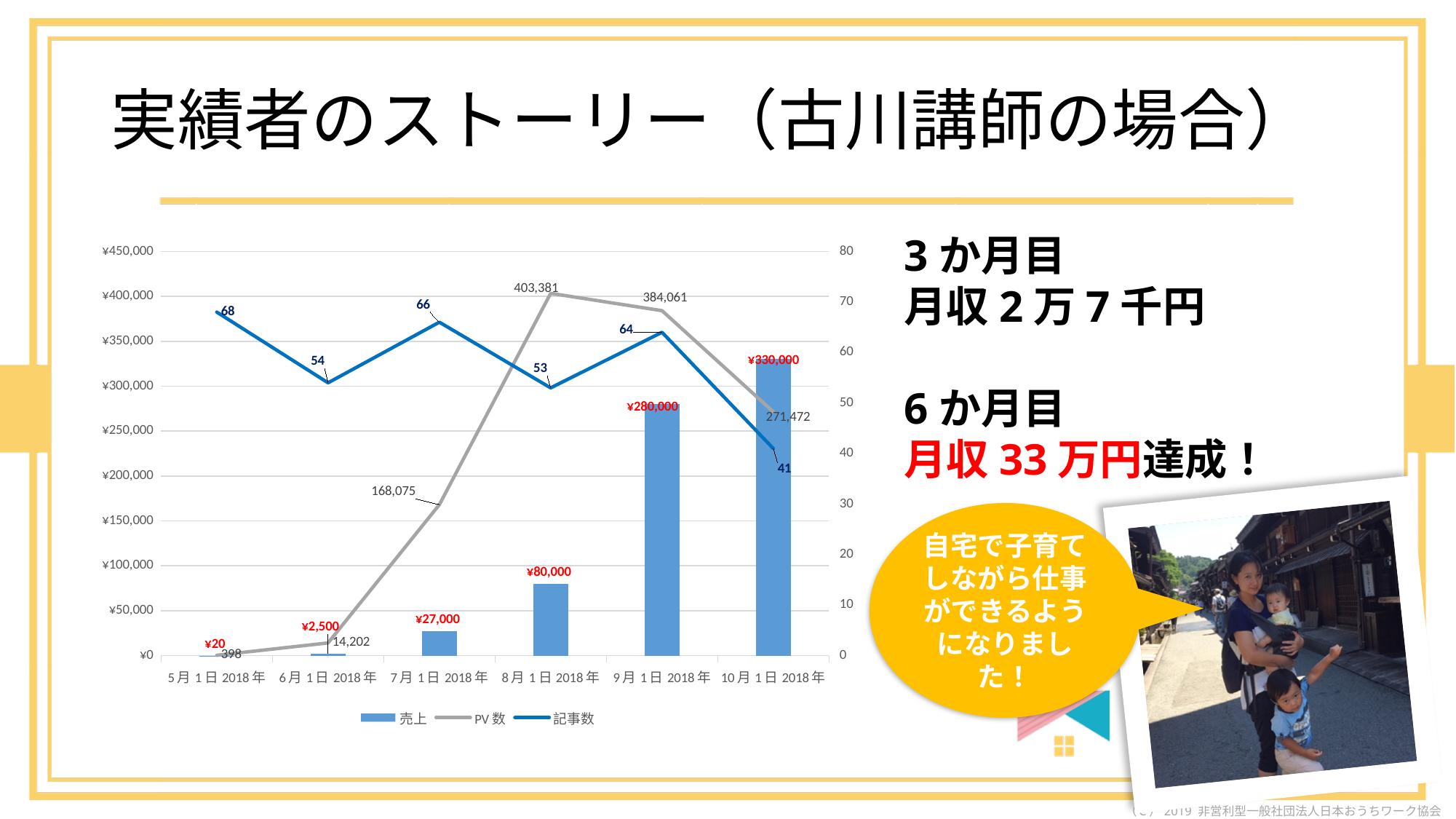
Which is larger, the PV数 for 8月1日 2018年 or for 9月1日 2018年? 8月1日 2018年 What is the difference in 売上 between 10月1日 2018年 and 9月1日 2018年? ¥50,000 What is the 売上 value for 9月1日 2018年? ¥280,000 Which month has the highest 売上? 10月1日 2018年 Which month has the lowest 記事数? 10月1日 2018年 Does the 売上 series rise or fall from 5月1日 2018年 to 10月1日 2018年? rise What is the PV数 value for 8月1日 2018年? 403,381 What is the 記事数 value for 5月1日 2018年? 68 Which series is drawn as bars? 売上 How many series does the legend list? 3 How many months are shown on the x axis? 6 What is the difference in 記事数 between 5月1日 2018年 and 6月1日 2018年? 14